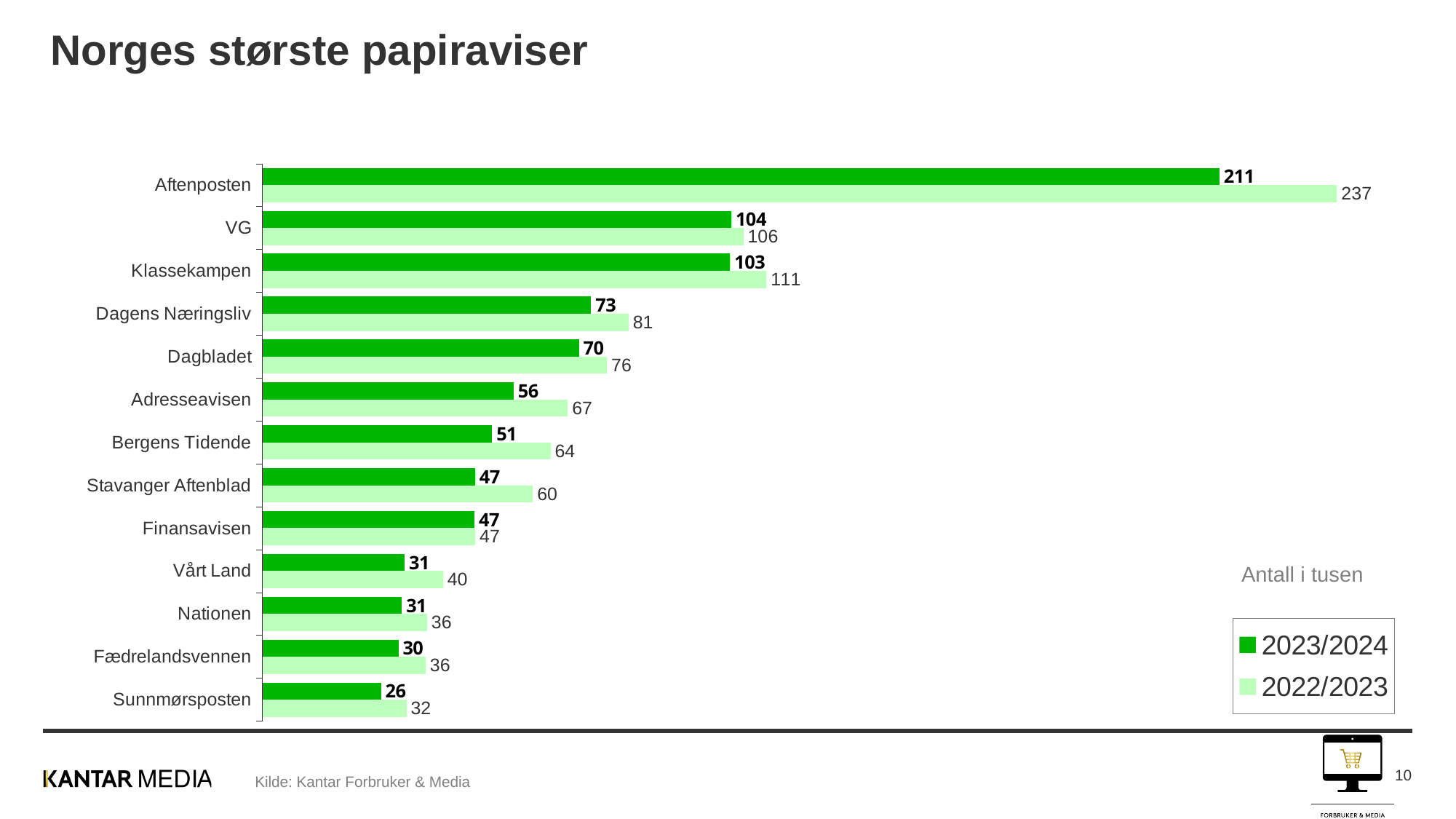
What unit note is shown next to the legend? Antall i tusen How many series does the legend list? 2 How many newspapers are shown in the chart? 13 Which is larger for Bergens Tidende: the 2023/2024 value or the 2022/2023 value? 2022/2023 What kind of chart is shown on the slide? Bar chart What is the 2023/2024 value for Aftenposten? 211 What is the difference between Adresseavisen's 2022/2023 and 2023/2024 values? 11 What is the 2022/2023 value for Klassekampen? 111 What is the difference between Aftenposten's 2022/2023 and 2023/2024 values? 26 Which newspaper has the highest 2023/2024 value? Aftenposten What is the 2023/2024 value for Dagens Næringsliv? 73 Which newspaper has the lowest 2022/2023 value? Sunnmørsposten